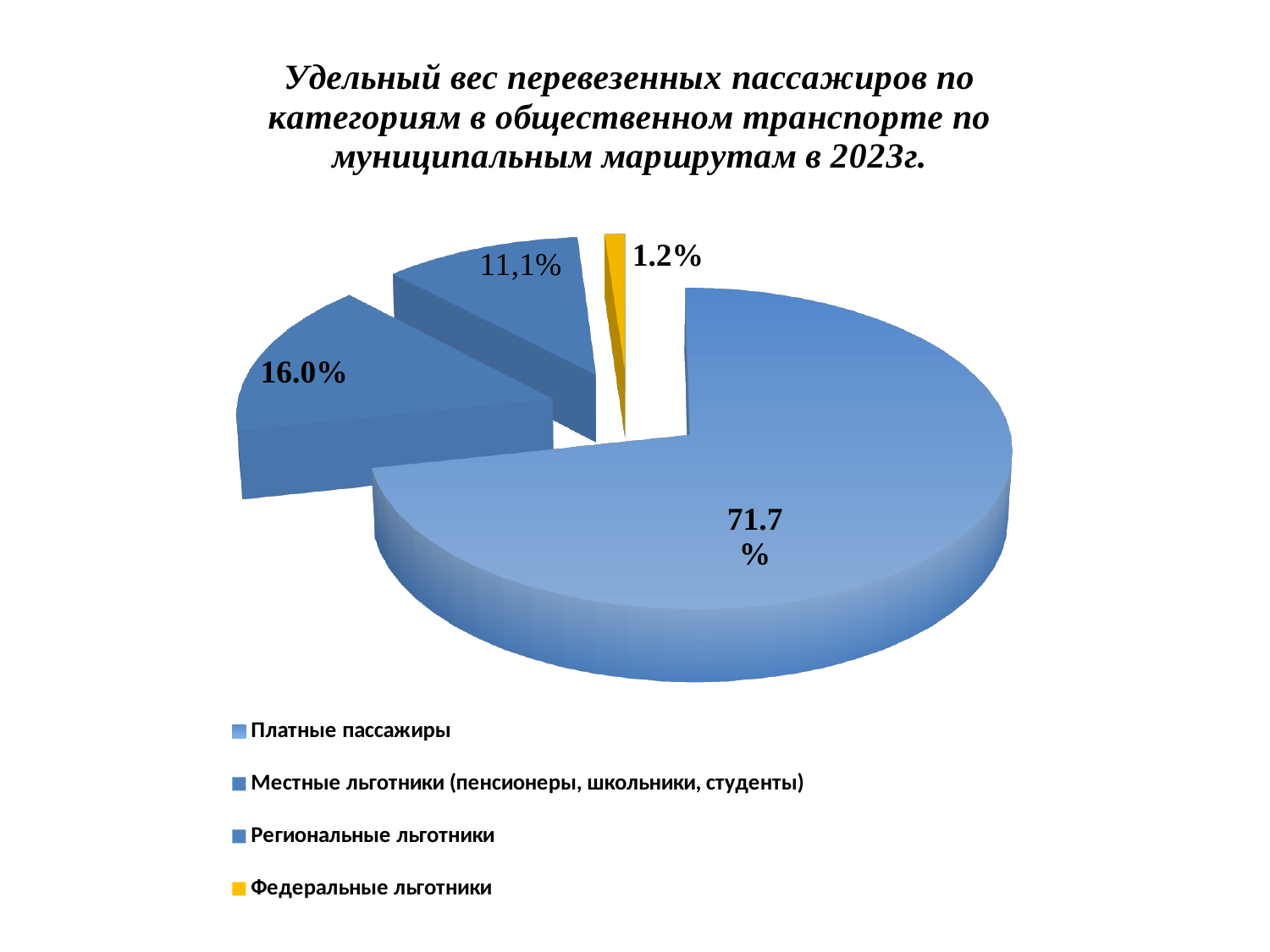
How many categories does the pie chart show? 4 What share is shown for Региональные льготники? 11,1% What year does the chart title refer to? 2023 Which category has the largest slice of the pie? Платные пассажиры What share is shown for Федеральные льготники? 1.2% What share is shown for Местные льготники (пенсионеры, школьники, студенты)? 16.0% What is the difference between the share for Платные пассажиры and the share for Местные льготники? 55.7% Which category is shown in yellow on the pie chart? Федеральные льготники What share of passengers is shown for Платные пассажиры? 71.7% What type of chart is shown on the slide? pie chart Which is larger: the share for Местные льготники or the share for Региональные льготники? Местные льготники Which category has the smallest slice of the pie? Федеральные льготники